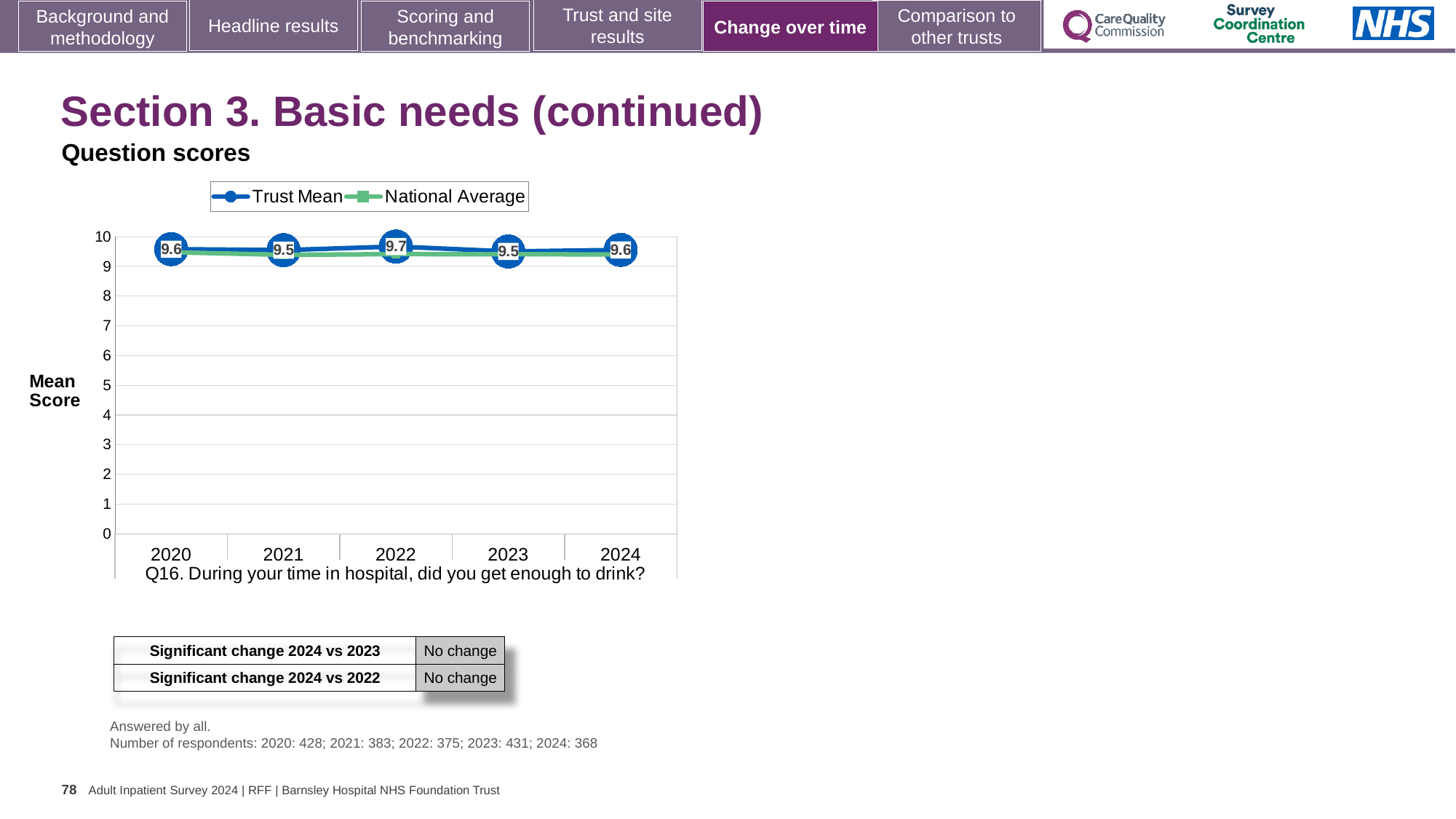
Which year has the larger Trust Mean score, 2022 or 2023? 2022 How many series does the legend list? 2 What is the Trust Mean score for 2020? 9.6 How many years are plotted on the x axis? 5 What is the Trust Mean score for 2024? 9.6 Which question does the chart show scores for? Q16. During your time in hospital, did you get enough to drink? Is the National Average value for 2024 greater or less than 9? greater What kind of chart is shown? line chart What is the difference between the Trust Mean scores for 2022 and 2021? 0.2 What is the Trust Mean score for 2022? 9.7 What is the Trust Mean score for 2023? 9.5 In which year is the Trust Mean score highest? 2022